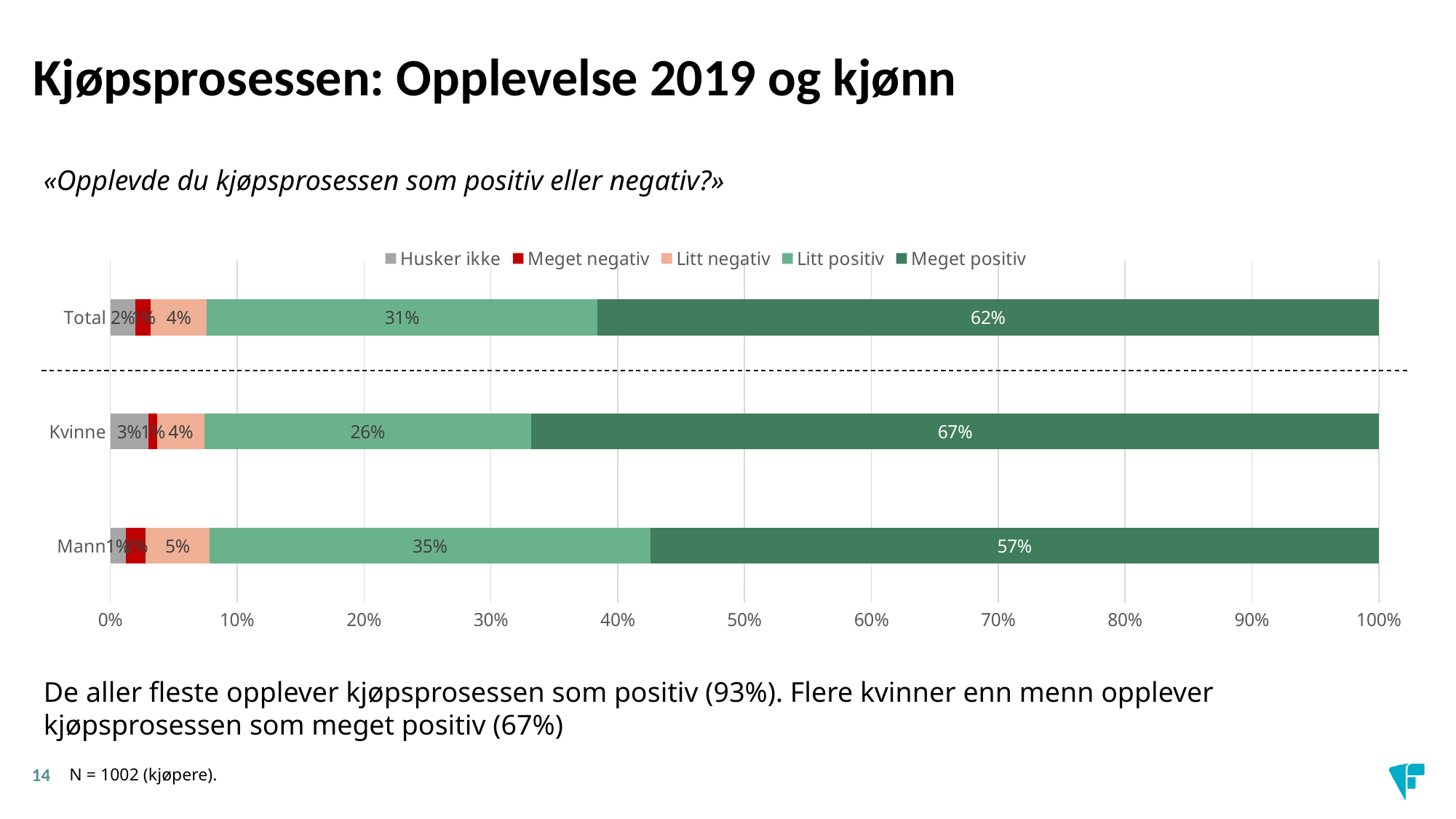
How many categories (bars) are plotted in the chart? 3 Which is larger, the 'Litt positiv' value for Total or for Mann? Mann What colour represents 'Meget negativ' in the legend? Red How many series does the legend list? 5 Which category has the lowest 'Litt positiv' value? Kvinne What is the value of 'Litt positiv' for Mann? 35% Which category has the highest 'Meget positiv' value? Kvinne What kind of chart is shown on the slide? Stacked bar chart What is the value of 'Meget positiv' for Total? 62% What is the difference between the 'Meget positiv' values for Kvinne and Mann? 10 percentage points What is the value of 'Meget positiv' for Kvinne? 67% What is the value of 'Litt negativ' for Total? 4%